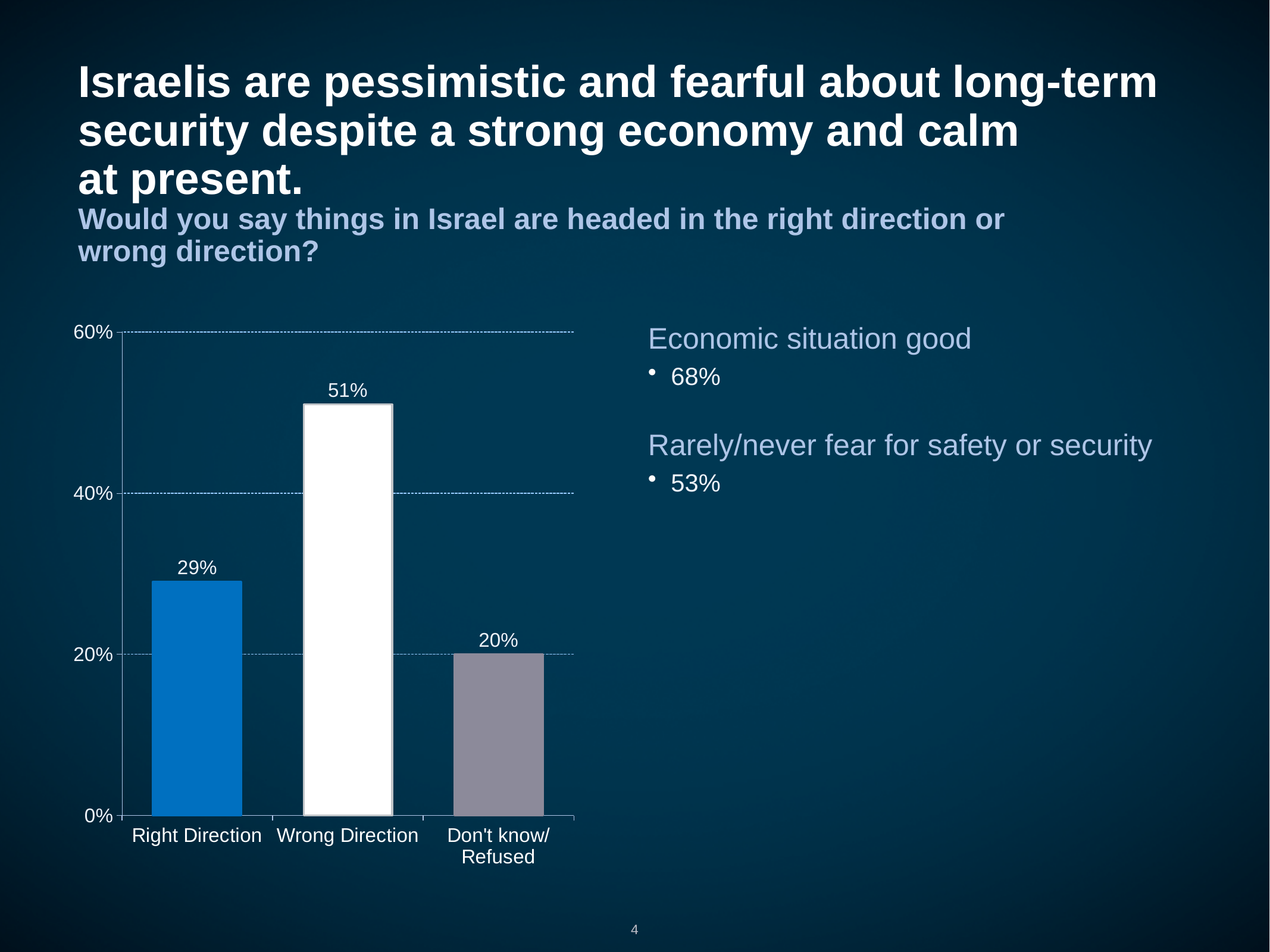
How many response categories are shown in the chart? 3 What kind of chart is shown on the slide? Bar chart What is the difference in percentage points between Wrong Direction and Right Direction? 22 percentage points Which response category has the lowest value in the chart? Don't know/Refused What percentage of respondents said things in Israel are headed in the Right Direction? 29% What percentage of respondents answered Don't know/Refused? 20% What is the difference in percentage points between Right Direction and Don't know/Refused? 9 percentage points Which is larger, the value for Right Direction or the value for Don't know/Refused? Right Direction What percentage of respondents said things in Israel are headed in the Wrong Direction? 51% What colour is the bar for Right Direction? Blue Is the value for Wrong Direction greater or less than 40%? greater Which response category has the highest value in the chart? Wrong Direction